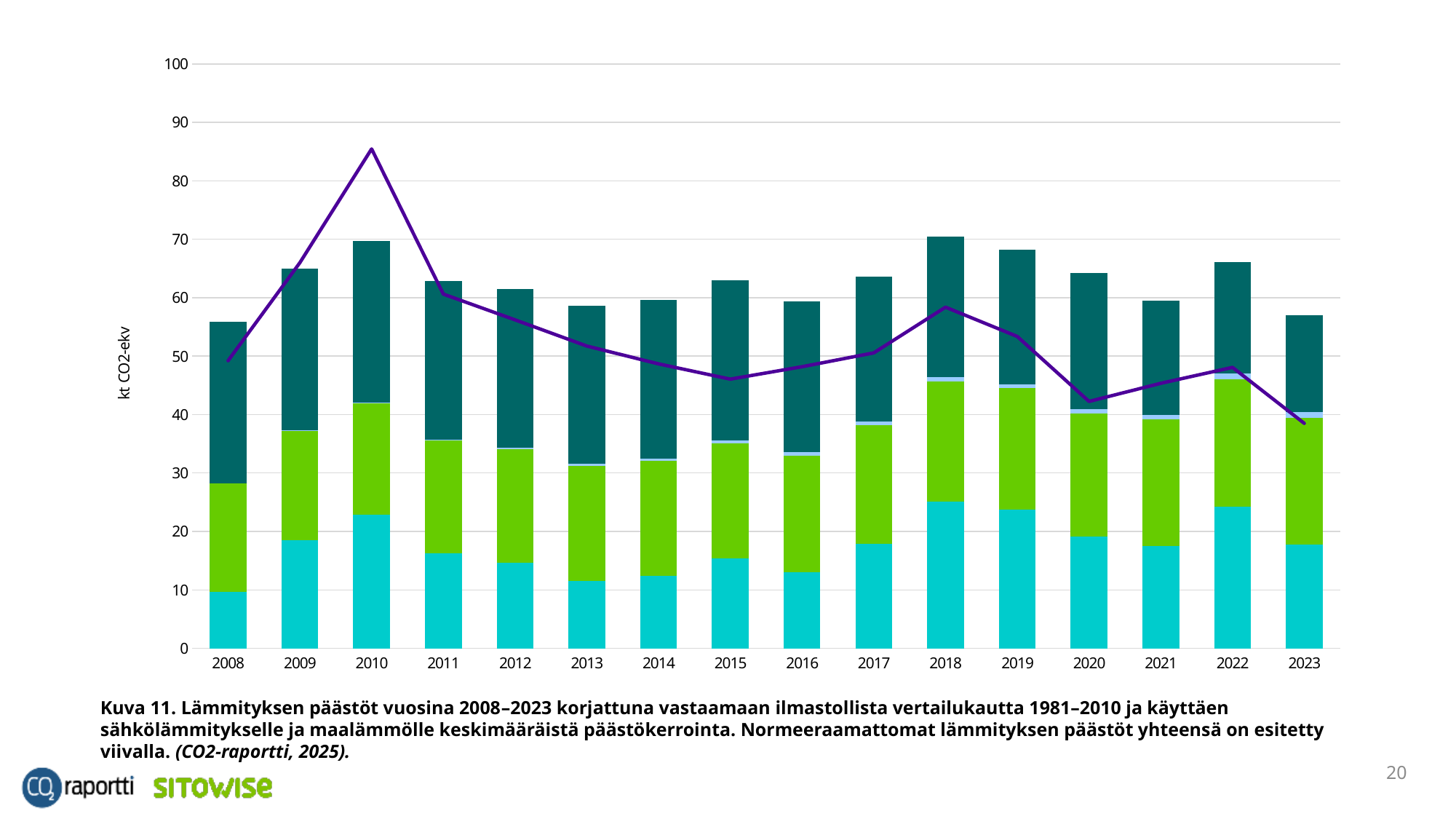
Is the total height of the stacked bar for 2013 greater or less than 60? less Is the value of the purple line in 2023 greater or less than 40? less Does the purple line rise or fall between 2010 and 2015? It falls Which year has the taller stacked bar, 2010 or 2013? 2010 What kind of chart is shown on the slide? A stacked bar chart with a line overlay What figure number is given in the caption below the chart? Kuva 11 In which year does the purple line reach its highest value? 2010 In which year does the purple line reach its lowest value? 2023 What is the label on the vertical axis of the chart? kt CO2-ekv Is the value of the purple line in 2010 greater or less than 80? greater How many years are shown on the x axis of the chart? 16